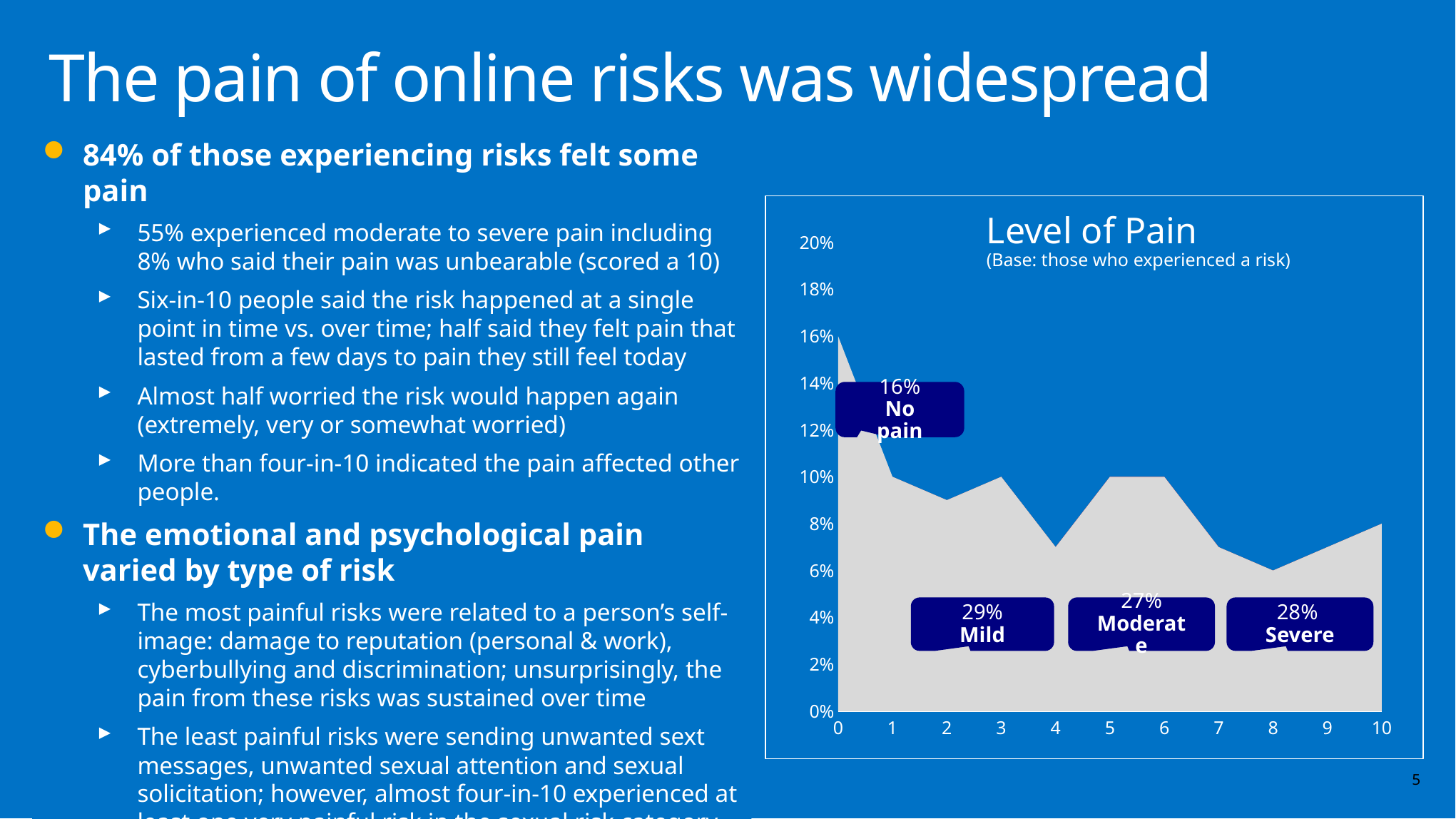
What percentage is shown for the Mild pain group? 29% What is the difference in percentage points between the Mild group and the Moderate group? 2 What is the title of the chart? Level of Pain What percentage is shown for the Severe pain group? 28% Which of the four labelled pain groups (No pain, Mild, Moderate, Severe) has the highest percentage? Mild Is the value at pain score 8 greater or less than 8%? less What percentage of respondents reported no pain, according to the chart label? 16% Which pain score on the x axis has the highest value in the chart? 0 Which of the four labelled pain groups has the lowest percentage? No pain What kind of chart is shown on the slide? area chart How many points are plotted along the x axis of the chart (from 0 to 10)? 11